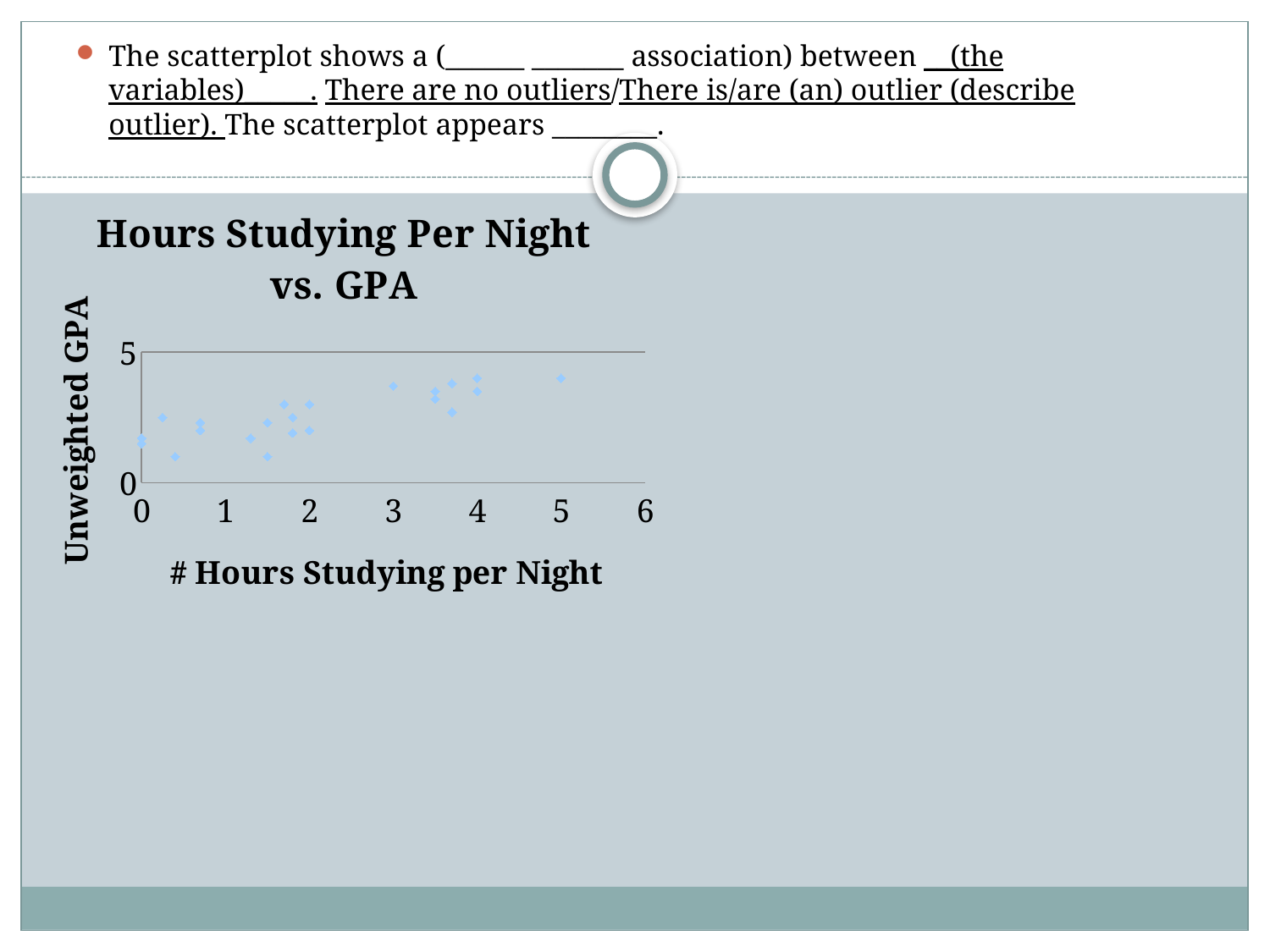
What kind of chart is shown on the slide? scatter plot Is the GPA of the point plotted at 5 hours studying per night greater or less than 3? greater As the number of hours studying per night increases, does the unweighted GPA generally rise or fall? rise What is the highest value shown on the vertical axis? 5 Is the GPA of the point plotted at 3 hours studying per night greater or less than 3? greater Do any points have more than 5 hours studying per night? No What is the title of the chart? Hours Studying Per Night vs. GPA What is the label of the vertical axis? Unweighted GPA